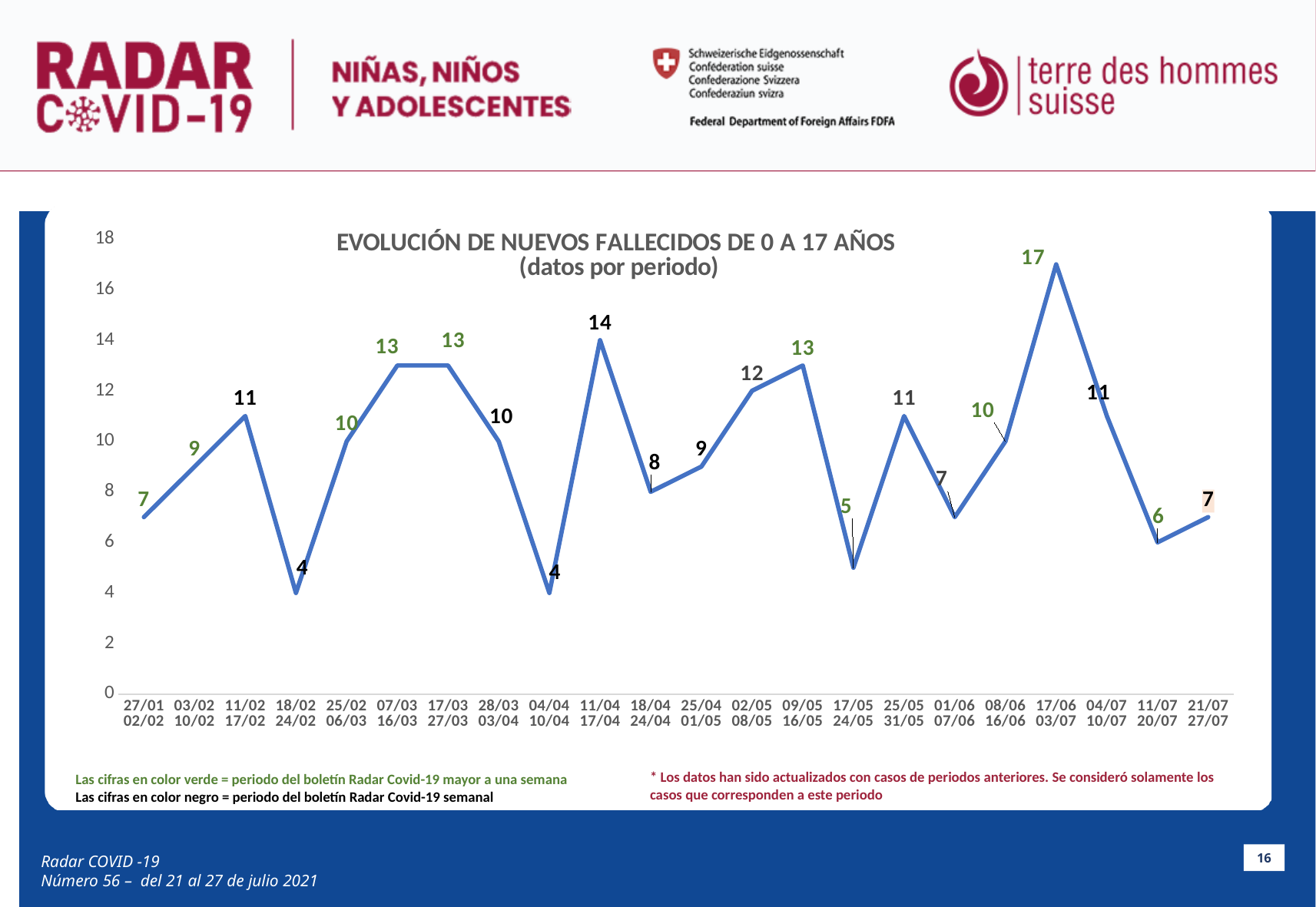
What type of chart is shown on the slide? line chart Which period has the highest value? 17/06-03/07 Which is larger, the value for 02/05-08/05 or the value for 25/05-31/05? 02/05-08/05 How many data points are plotted on the line? 22 What is the value for the last period, 21/07-27/07? 7 What is the lowest value plotted on the chart? 4 What is the title of the chart? EVOLUCIÓN DE NUEVOS FALLECIDOS DE 0 A 17 AÑOS (datos por periodo) What is the difference between the value for 17/06-03/07 and the value for 04/07-10/07? 6 Do the values rise or fall from 09/05-16/05 to 17/05-24/05? fall According to the note below the chart, what do the green figures indicate? periodo del boletín Radar Covid-19 mayor a una semana What is the value for the period 11/04-17/04? 14 What is the value for the period 17/05-24/05? 5